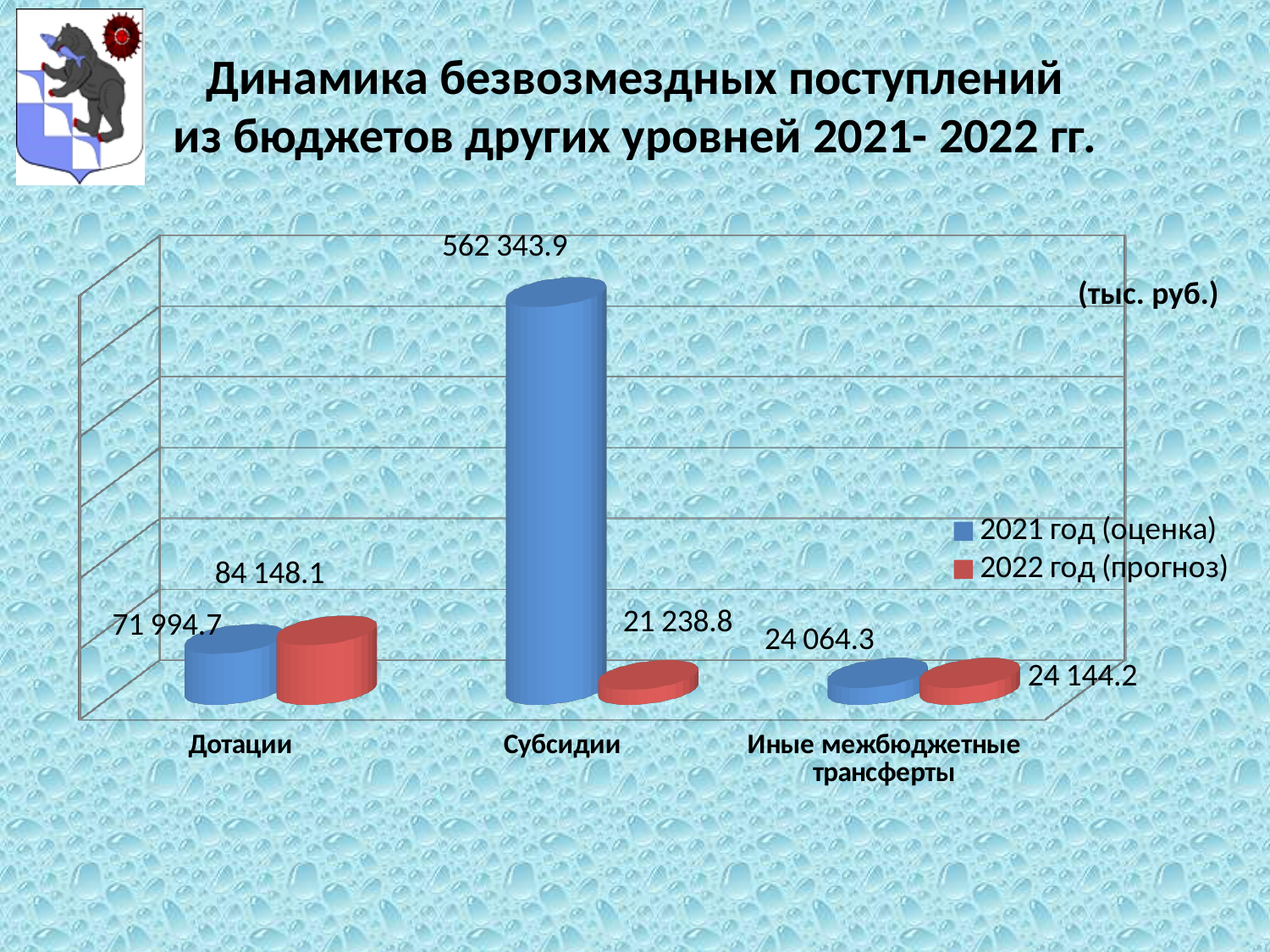
What is the value for Субсидии in the 2021 год (оценка) series? 562 343.9 What is the value for Дотации in the 2022 год (прогноз) series? 84 148.1 Which category has the highest value in the 2021 год (оценка) series? Субсидии How many series does the legend list? 2 What kind of chart is shown on the slide? Bar chart For Дотации, which series has the larger value: 2021 год (оценка) or 2022 год (прогноз)? 2022 год (прогноз) What is the difference between the 2021 год (оценка) and 2022 год (прогноз) values for Субсидии? 541 105.1 Which category has the lowest value in the 2022 год (прогноз) series? Субсидии How many categories are shown on the x axis? 3 What is the difference between the 2022 год (прогноз) and 2021 год (оценка) values for Дотации? 12 153.4 What is the value for Субсидии in the 2022 год (прогноз) series? 21 238.8 What is the value for Иные межбюджетные трансферты in the 2021 год (оценка) series? 24 064.3